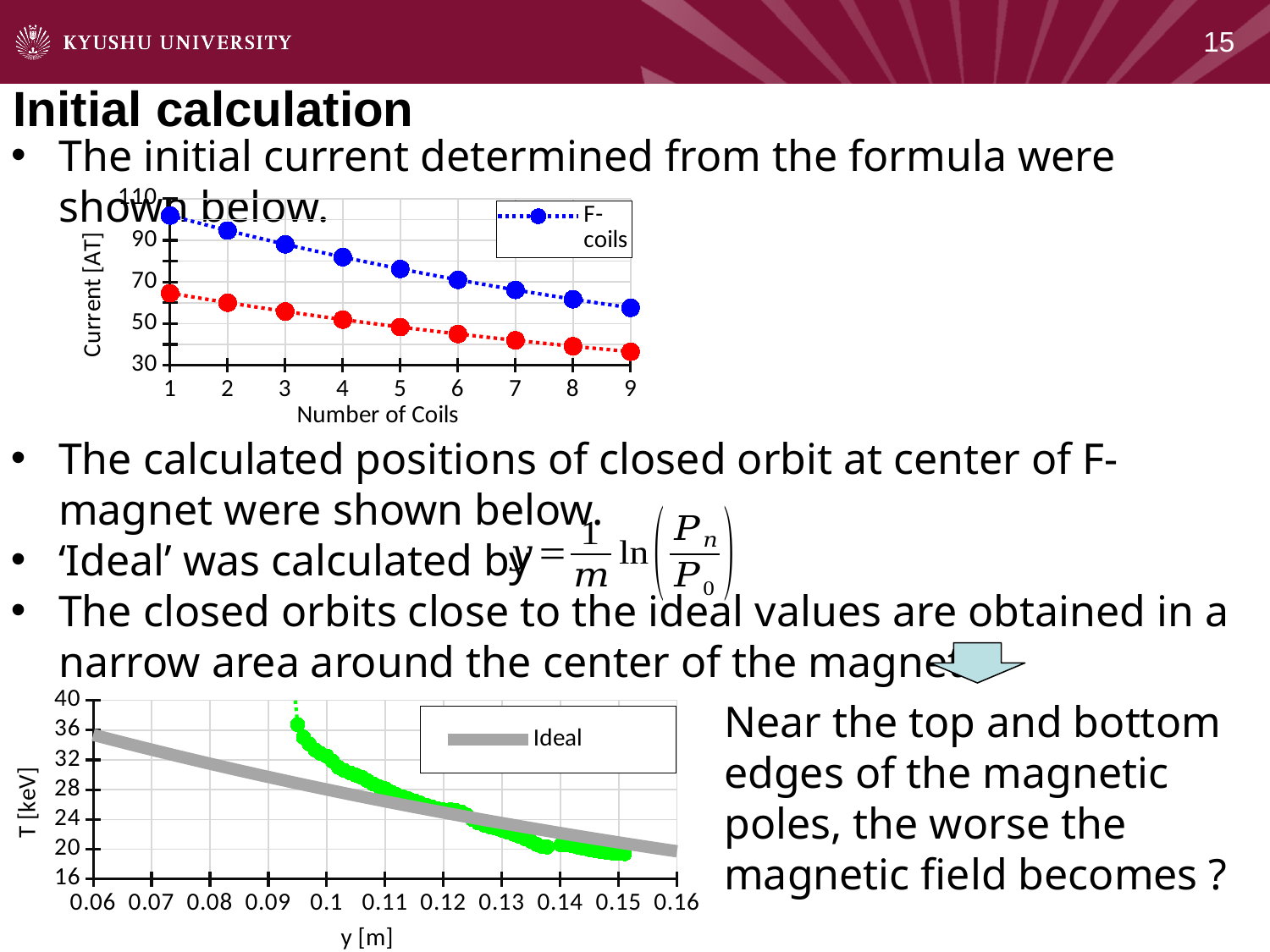
In the top chart (Current vs Number of Coils), is the F-coils value at 3 coils greater or less than 70? greater In the top chart (Current vs Number of Coils), what kind of chart is it? line chart In the bottom chart (T vs y), what entry does the legend list? Ideal In the top chart (Current vs Number of Coils), is the F-coils value at 1 coil greater or less than 90? greater In the top chart (Current vs Number of Coils), which series has the larger value at 1 coil, the blue F-coils series or the red series? F-coils In the bottom chart (T vs y), is the Ideal value at y = 0.06 greater or less than 32? greater In the top chart (Current vs Number of Coils), how many coil numbers are shown on the x axis? 9 In the top chart (Current vs Number of Coils), what is the label of the y axis? Current [AT] In the bottom chart (T vs y), how does the Ideal line change as y increases from 0.06 to 0.16? it falls In the top chart (Current vs Number of Coils), how do the current values change as the number of coils increases? they fall